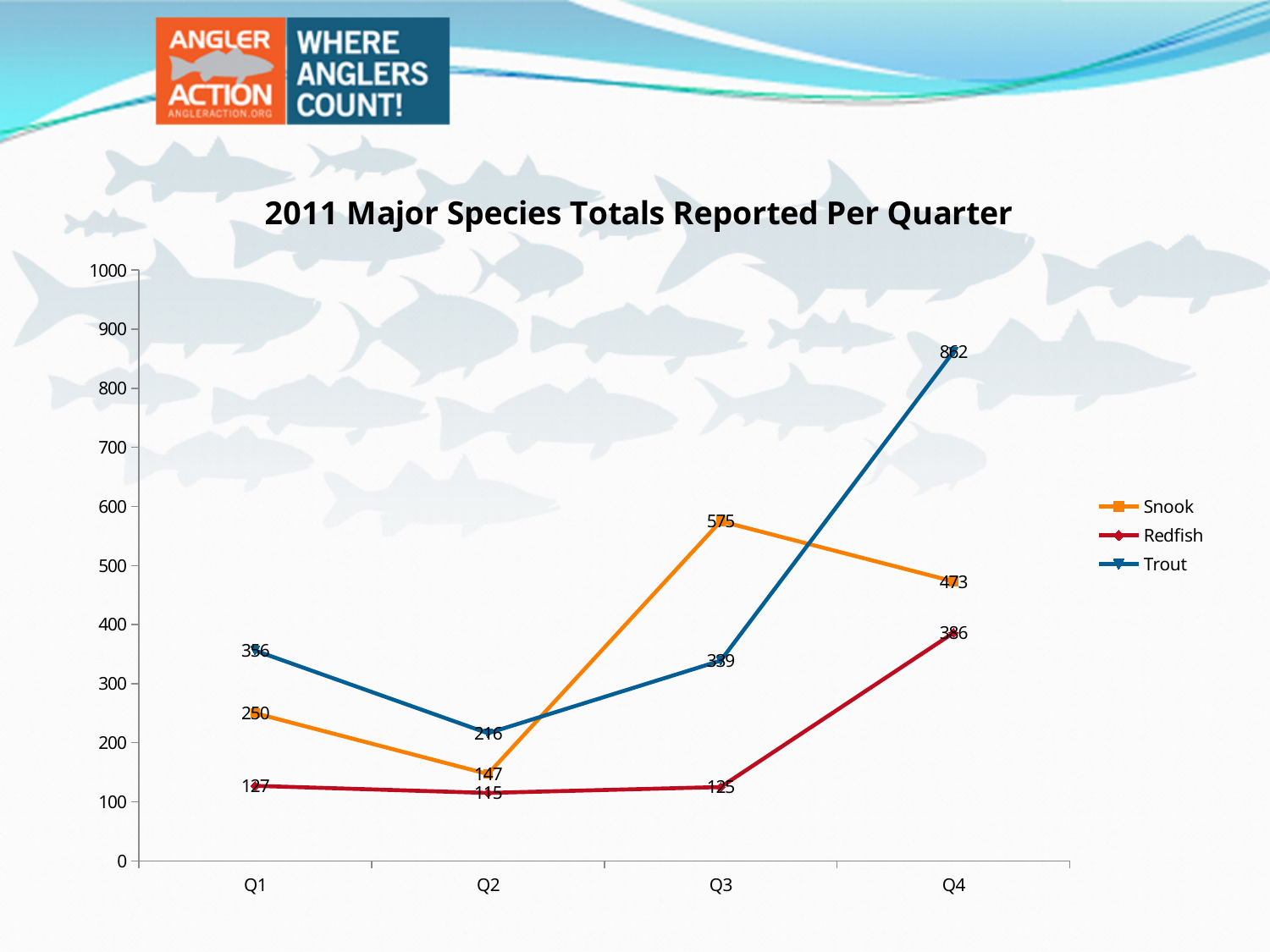
What is the difference between the Snook values for Q3 and Q4? 102 Is the Trout value for Q4 greater or less than 800? greater What kind of chart is shown on the slide? line chart In which quarter is the Snook value highest? Q3 What is the Snook value for Q3? 575 How many series does the legend list? 3 How many quarters are plotted along the x axis? 4 In Q1, which is larger, the Snook value or the Trout value? Trout In which quarter is the Redfish value lowest? Q2 What is the title of the chart? 2011 Major Species Totals Reported Per Quarter What is the Redfish value for Q4? 386 What is the Trout value for Q2? 216